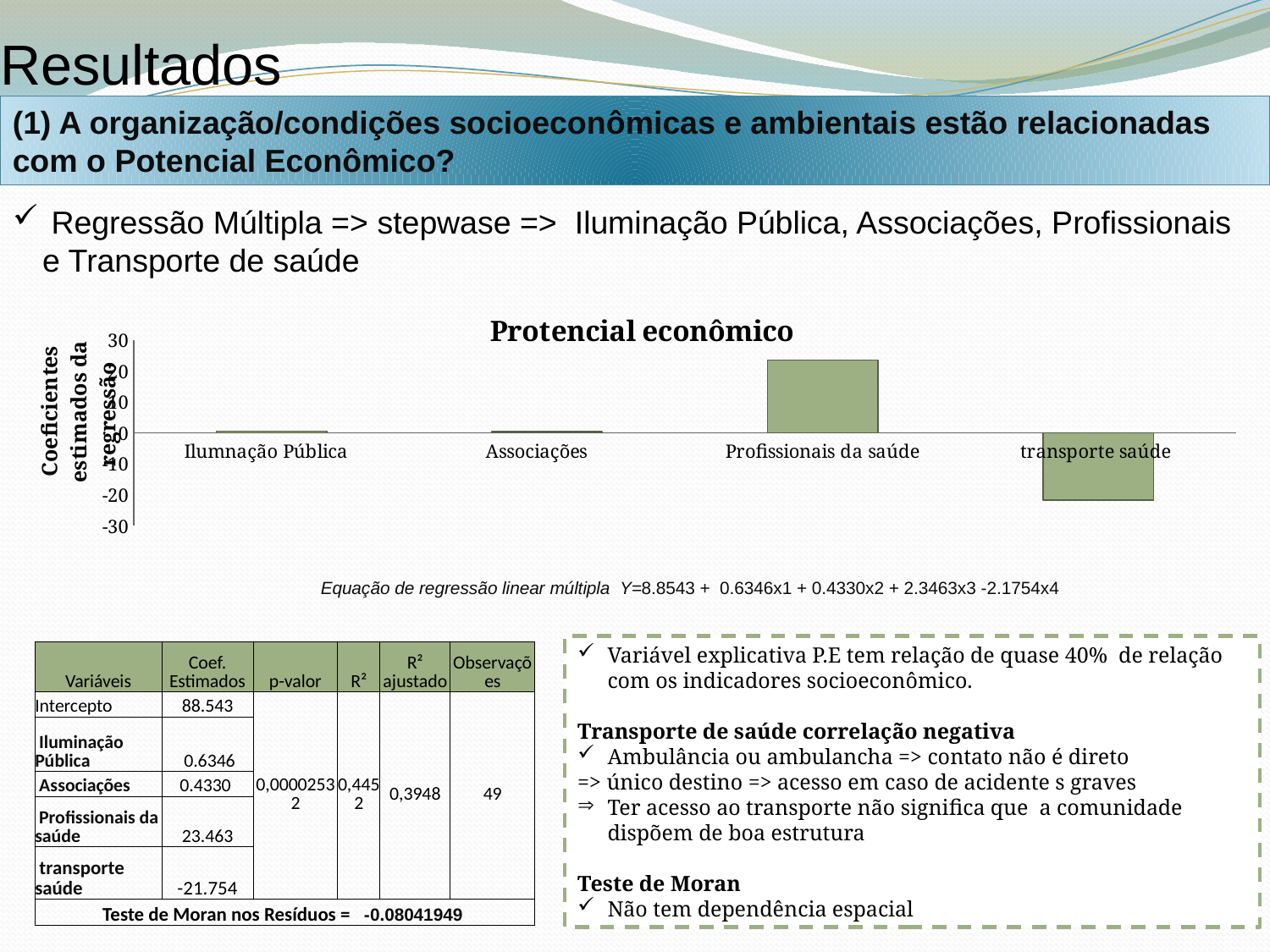
How many categories are plotted in the chart? 4 Is the value for transporte saúde greater or less than -10? less Is the value for Profissionais da saúde greater or less than 20? greater What kind of chart is shown on the slide? bar chart Which is larger, the value for Profissionais da saúde or the value for Ilumnação Pública? Profissionais da saúde What is the title of the chart? Protencial econômico Which category has the highest value in the chart? Profissionais da saúde What is the label of the vertical axis of the chart? Coeficientes estimados da regressão Which is larger, the value for Associações or the value for transporte saúde? Associações Which category has the lowest value in the chart? transporte saúde Is the value for Ilumnação Pública greater or less than 10? less